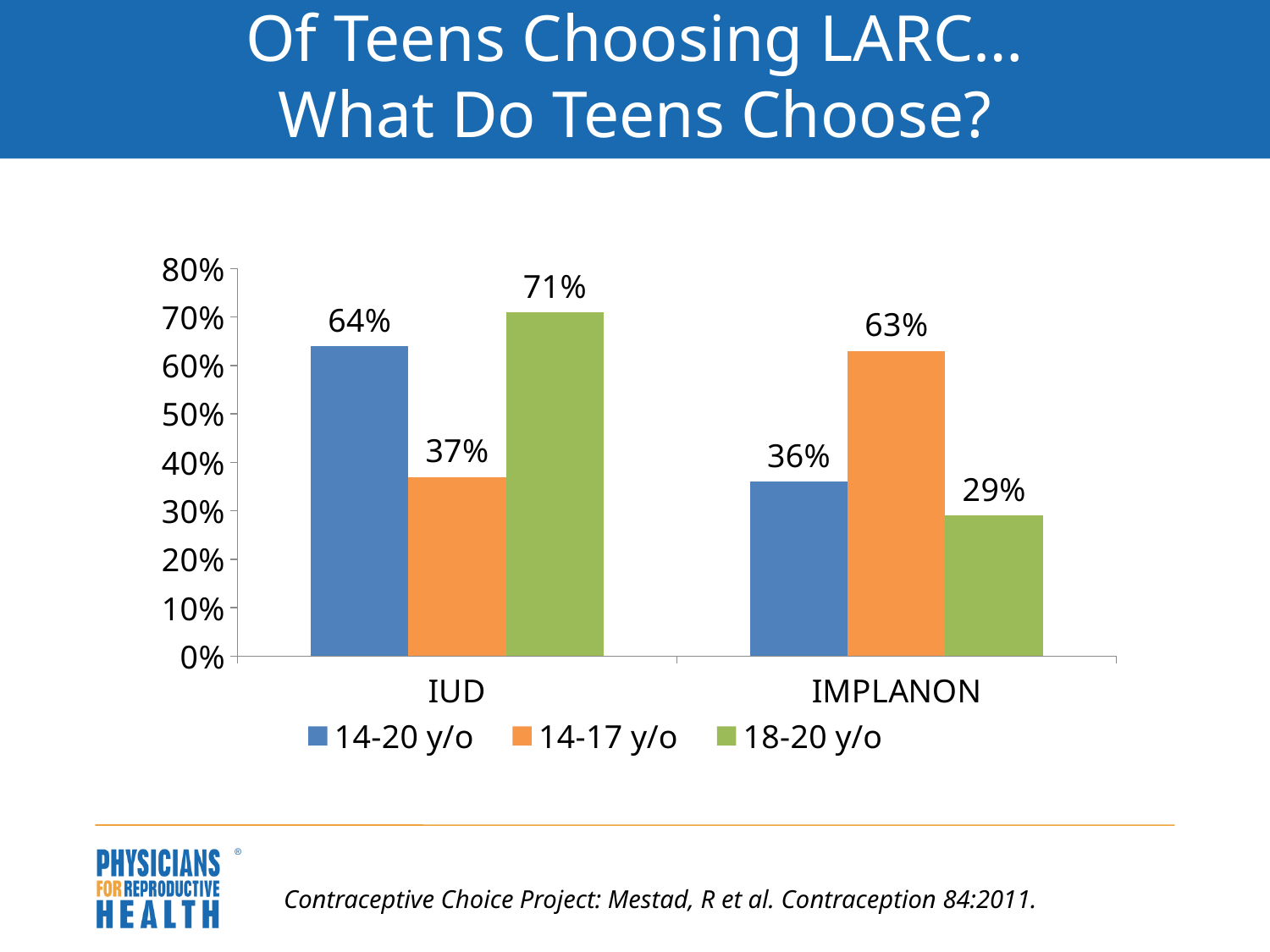
How many series does the legend list? 3 Which is larger for 14-17 y/o: the IUD value or the IMPLANON value? IMPLANON What percentage of 14-20 y/o teens chose IUD? 64% Which age group has the lowest value for IMPLANON? 18-20 y/o What percentage of 14-17 y/o teens chose IMPLANON? 63% Which colour represents the 14-17 y/o series in the legend? Orange How many categories are shown on the x axis? 2 What percentage of 18-20 y/o teens chose IUD? 71% What kind of chart is shown on the slide? Bar chart What percentage of 18-20 y/o teens chose IMPLANON? 29% What is the difference between the 18-20 y/o values for IUD and IMPLANON? 42% Which age group has the highest value for IUD? 18-20 y/o